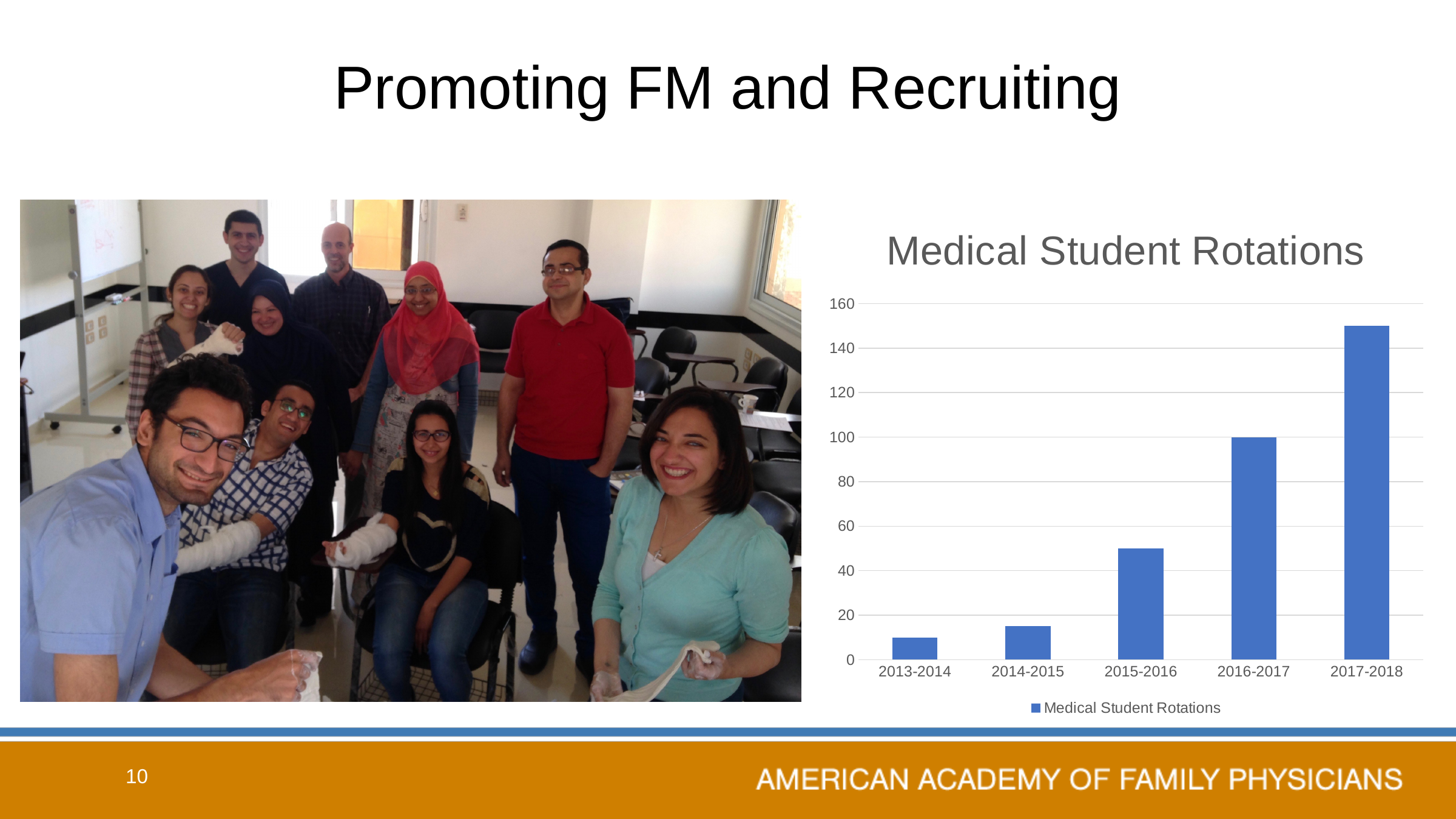
What is the value for 2016-2017 in the Medical Student Rotations chart? 100 How many series does the legend of the Medical Student Rotations chart list? 1 What type of chart is shown under the title "Medical Student Rotations"? bar chart Is the value for 2017-2018 greater or less than 140? greater Which is larger in the Medical Student Rotations chart, the value for 2014-2015 or the value for 2015-2016? 2015-2016 What is the legend entry shown below the Medical Student Rotations chart? Medical Student Rotations Which academic year has the lowest value in the Medical Student Rotations chart? 2013-2014 How many academic years are shown on the x axis of the Medical Student Rotations chart? 5 Which academic year has the highest value in the Medical Student Rotations chart? 2017-2018 Do the values in the Medical Student Rotations chart rise or fall from 2013-2014 to 2017-2018? rise Is the value for 2015-2016 greater or less than 40? greater Is the value for 2013-2014 greater or less than 20? less